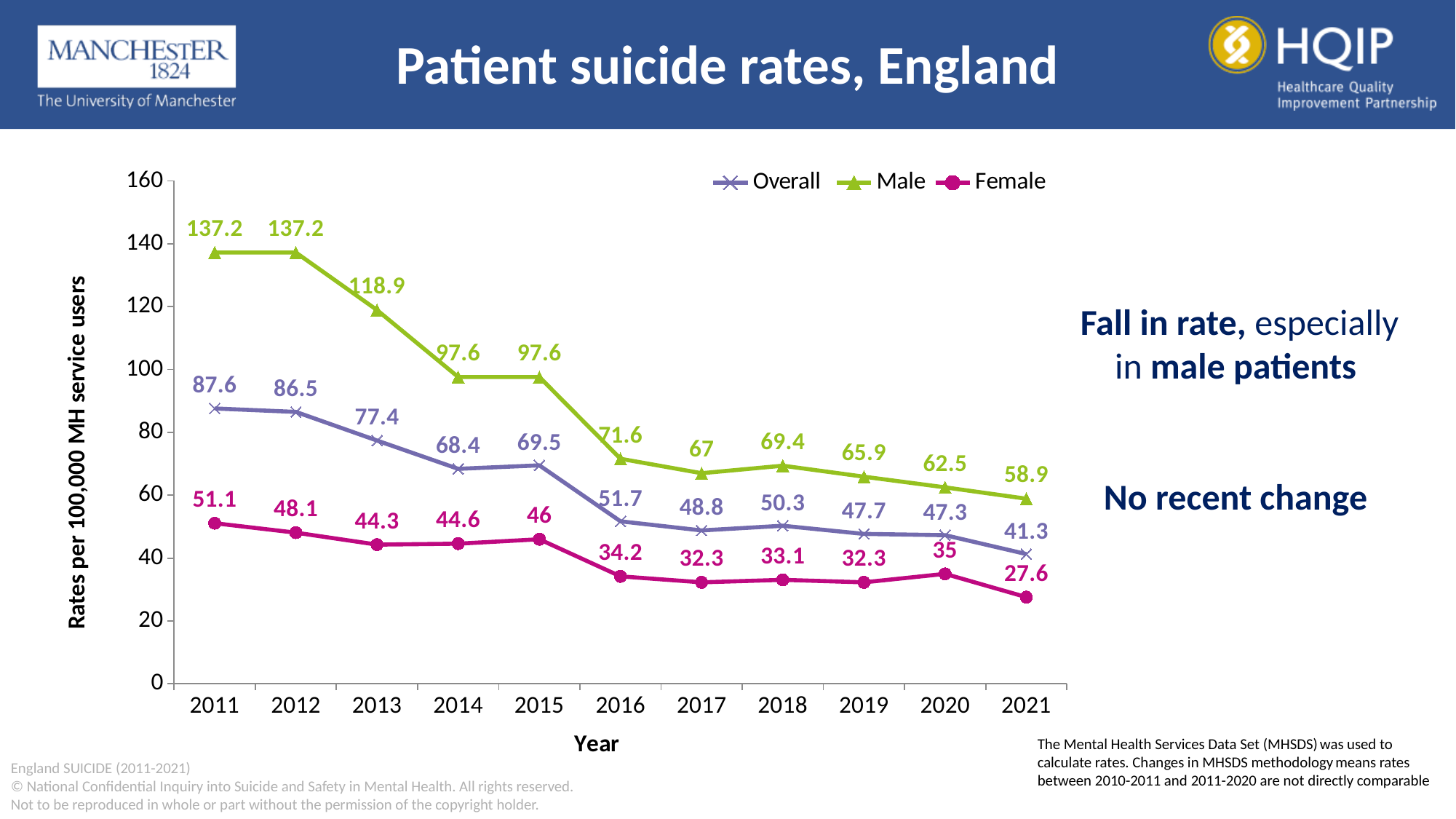
What is the label of the y axis? Rates per 100,000 MH service users What is the difference between the Male rate in 2011 and the Male rate in 2021? 78.3 How many series does the legend list? 3 In which year is the Female rate lowest? 2021 Which is larger, the Overall rate in 2018 or the Overall rate in 2019? 2018 What kind of chart is shown on the slide? line chart How many years are shown on the x axis? 11 What is the Male rate in 2013? 118.9 What is the Overall rate in 2016? 51.7 What is the Female rate in 2021? 27.6 In which year is the Overall rate highest? 2011 Does the Male rate generally rise or fall from 2011 to 2021? fall